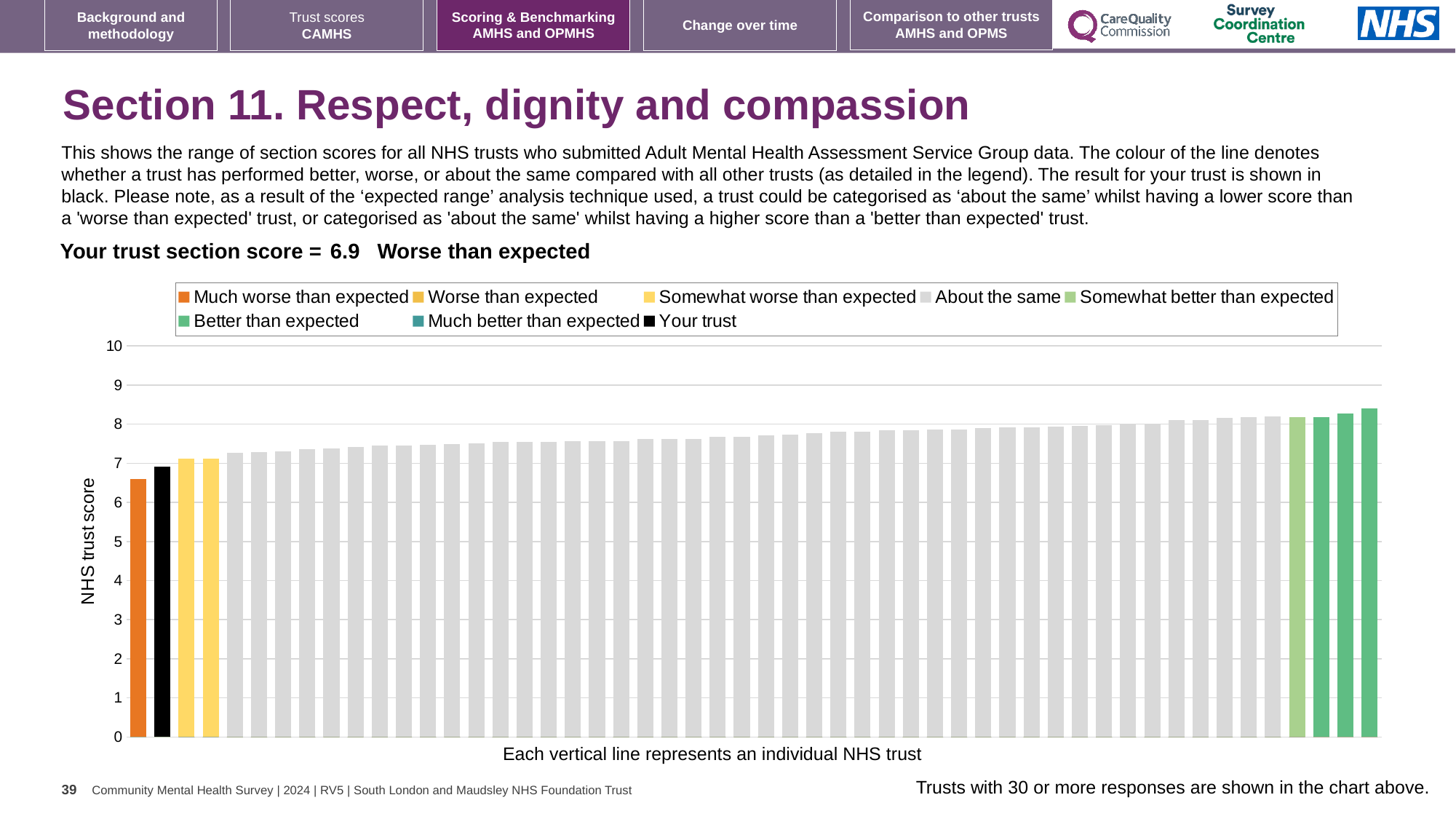
Is the value of the tallest bar greater or less than 8? greater What is the section score for your trust shown on the slide? 6.9 How many bars in the chart are coloured orange (Much worse than expected)? 1 How many bars in the chart are coloured dark green (Better than expected)? 3 Is the value of the shortest (orange) bar greater or less than 7? less Do the bar values rise or fall from left to right across the chart? rise Which legend category does the tallest bar in the chart belong to? Better than expected Which legend category does the shortest bar in the chart belong to? Much worse than expected Is the value of the black 'Your trust' bar greater or less than 6? greater What kind of chart is shown on the slide? bar chart What is the label on the vertical axis of the chart? NHS trust score How many entries does the chart legend list? 8